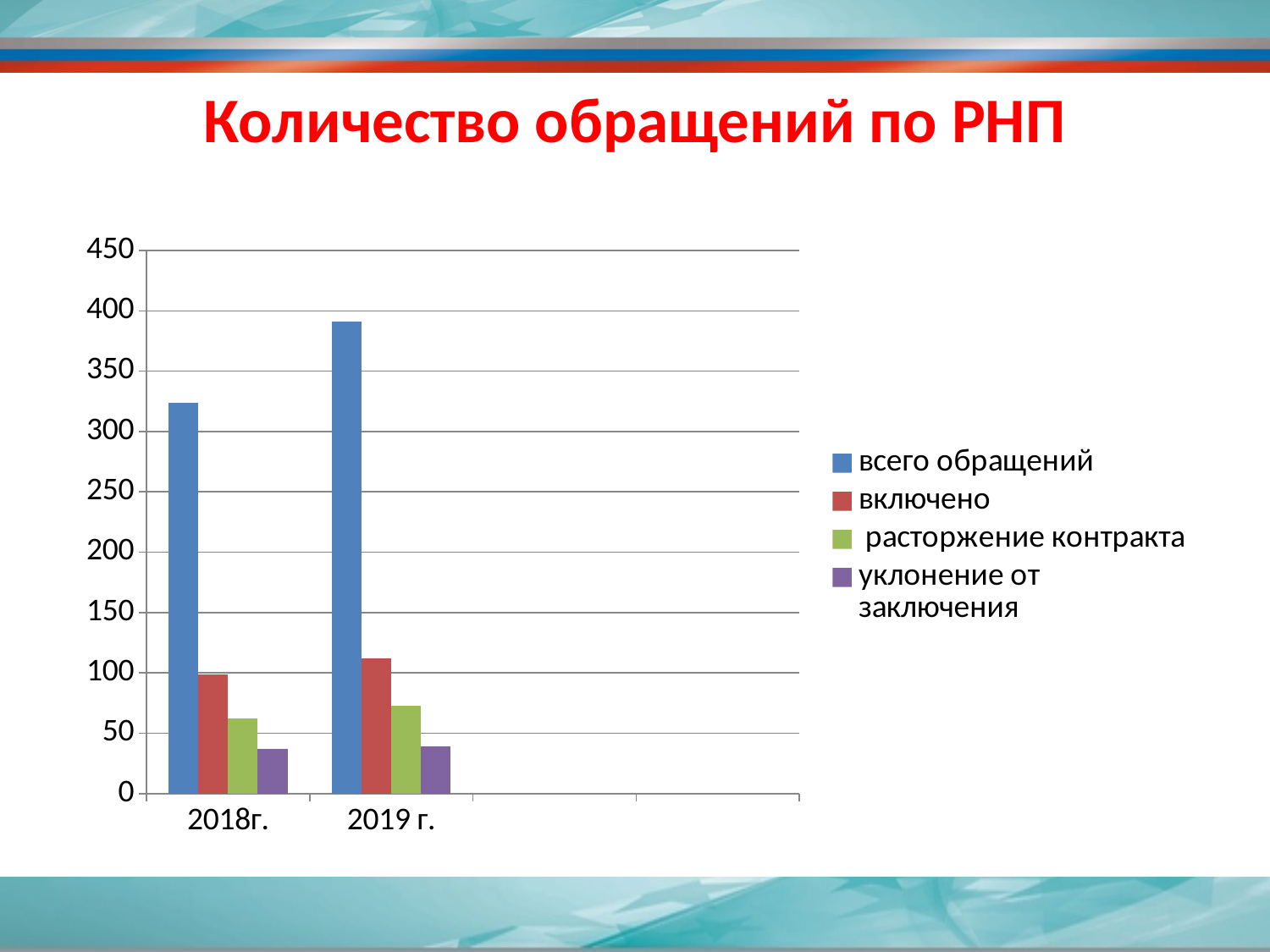
How many series does the legend list? 4 Is the value for всего обращений in 2019 г. greater or less than 400? less What is the title of the chart? Количество обращений по РНП Is the value for всего обращений in 2018г. greater or less than 300? greater How many year categories are shown on the x axis? 2 Is the value for всего обращений in 2019 г. greater or less than 350? greater Which series has the lowest value in 2018г.? уклонение от заключения What kind of chart is shown on the slide? bar chart Which series has the highest value in 2019 г.? всего обращений Which year has the larger value for всего обращений, 2018г. or 2019 г.? 2019 г.